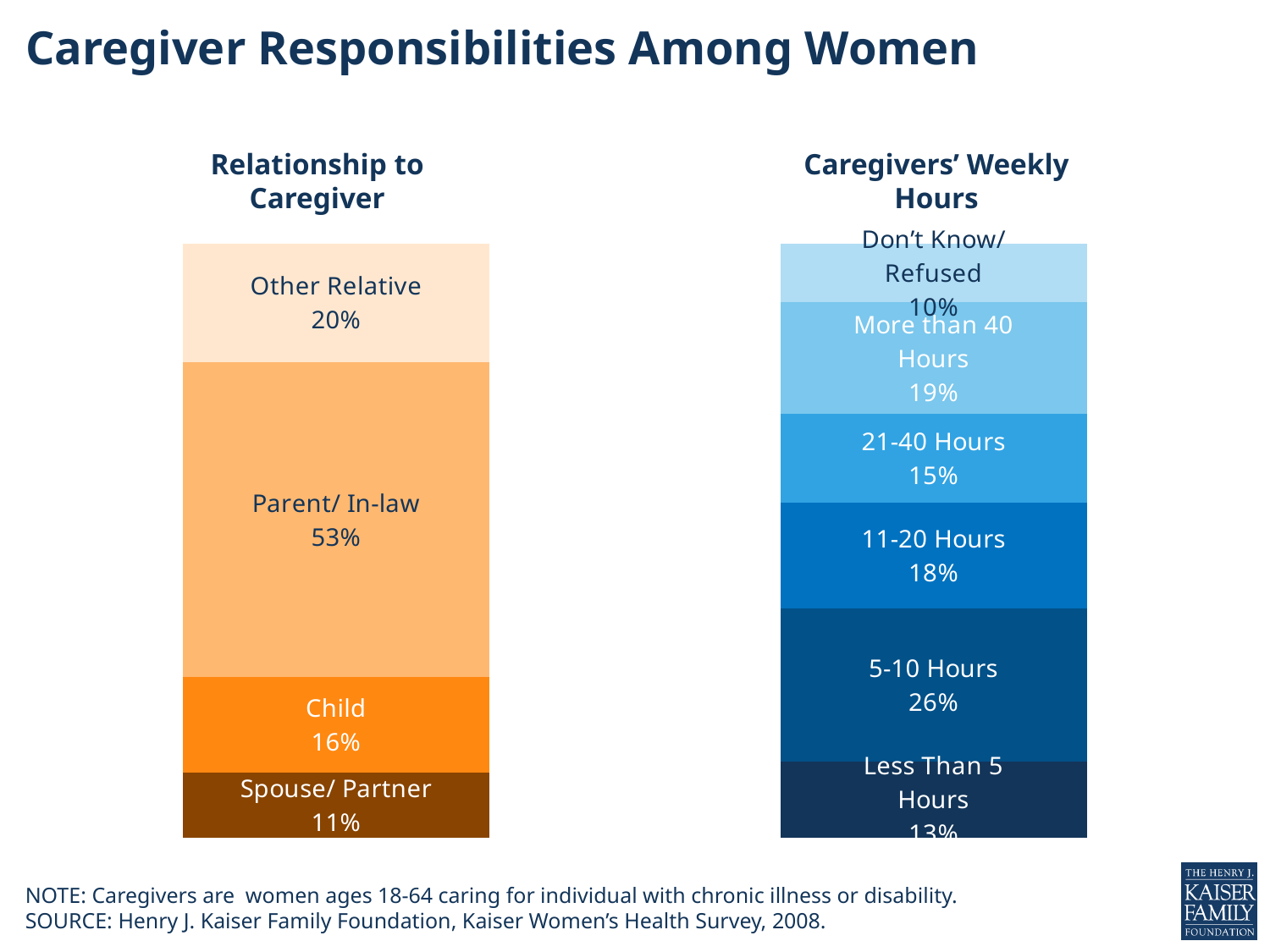
In the 'Caregivers' Weekly Hours' chart, what percentage of caregivers provide More than 40 Hours per week? 19% In the 'Relationship to Caregiver' chart, what is the difference between the Other Relative and Child percentages? 4 percentage points In the 'Caregivers' Weekly Hours' chart, what percentage of caregivers provide 5-10 Hours per week? 26% In the 'Caregivers' Weekly Hours' chart, which category has the largest share? 5-10 Hours In the 'Relationship to Caregiver' chart, which relationship category has the largest share? Parent/ In-law What type of chart is used for 'Relationship to Caregiver'? Stacked bar chart In the 'Relationship to Caregiver' chart, what percentage of caregivers care for a Spouse/ Partner? 11% In the 'Relationship to Caregiver' chart, which relationship category has the smallest share? Spouse/ Partner In the 'Relationship to Caregiver' chart, what percentage of caregivers care for a Parent/ In-law? 53% In the 'Relationship to Caregiver' chart, how many relationship categories are shown? 4 In the 'Caregivers' Weekly Hours' chart, which is larger: 11-20 Hours or 21-40 Hours? 11-20 Hours In the 'Caregivers' Weekly Hours' chart, how many categories are shown? 6